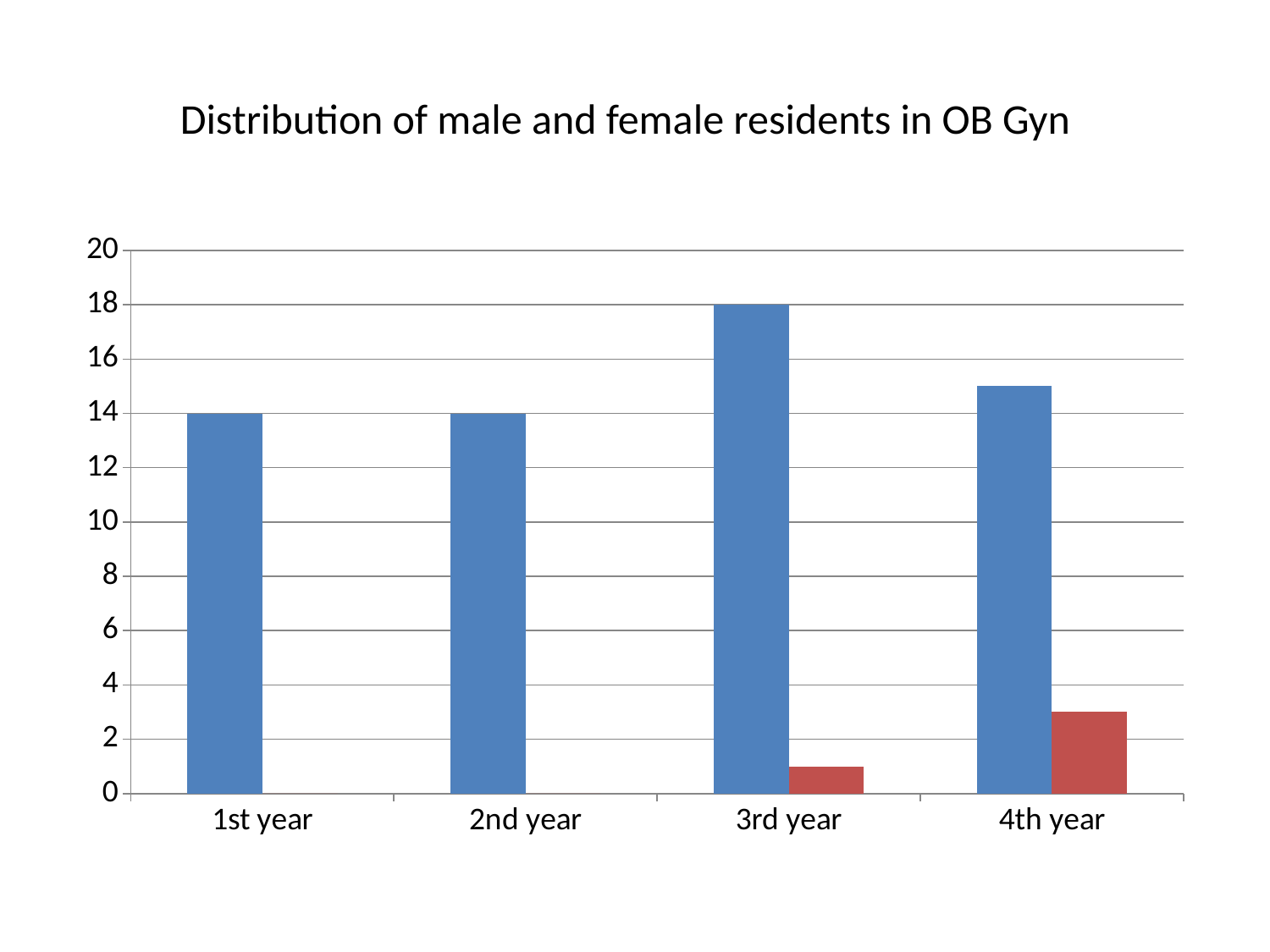
What is the value of the blue bar for 1st year? 14 What is the value of the blue bar for 2nd year? 14 What type of chart is shown on the slide? bar chart What is the difference between the blue bars for 3rd year and 1st year? 4 Which is larger, the blue bar for 3rd year or the blue bar for 4th year? 3rd year What is the value of the blue bar for 3rd year? 18 Is the blue bar for 4th year greater or less than 14? greater Is the red bar for 3rd year greater or less than 2? less Is the red bar for 4th year greater or less than 4? less How many year categories are shown on the x axis? 4 Which year has the highest red bar? 4th year Which year has the highest blue bar? 3rd year